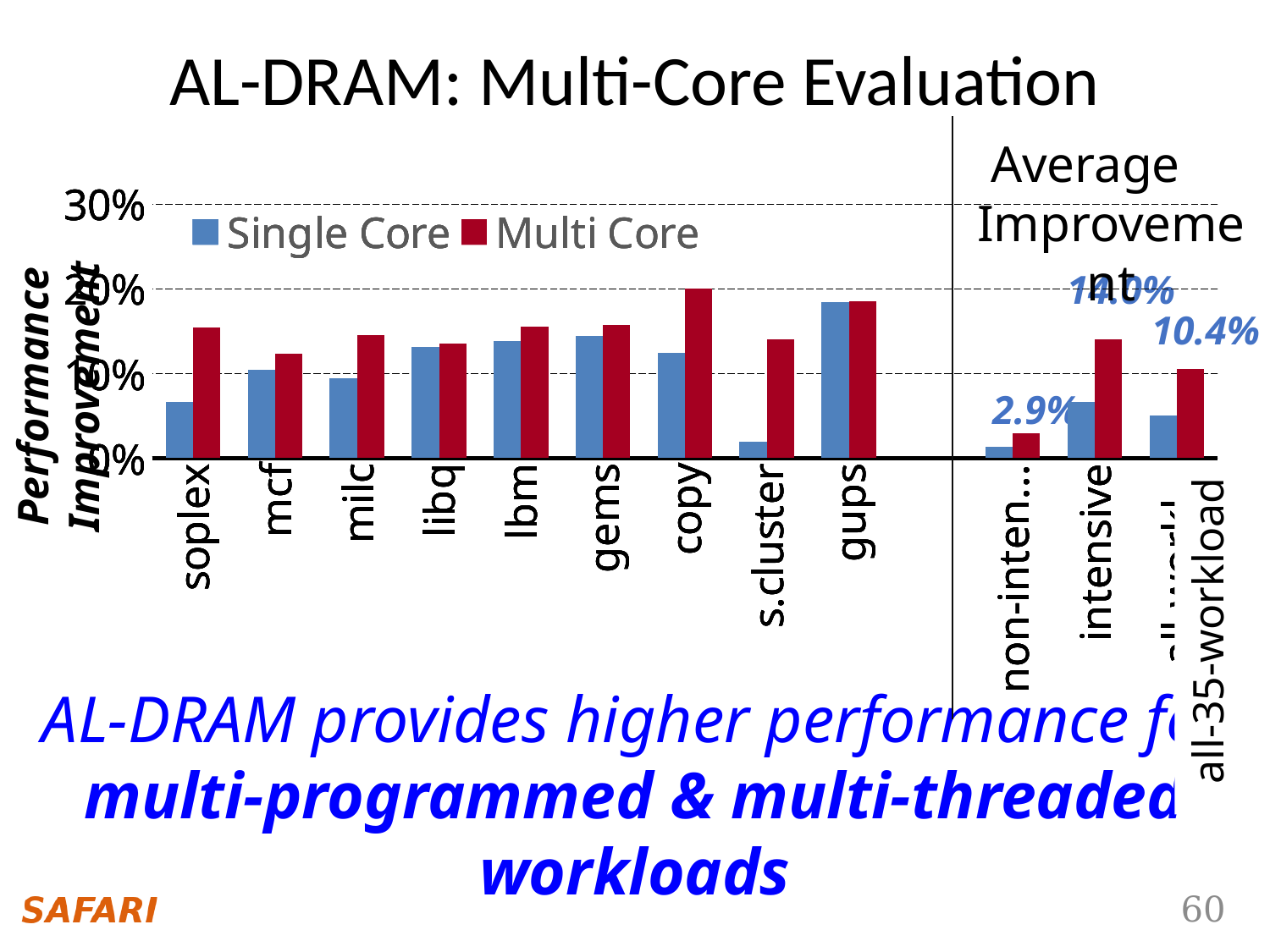
What average improvement value is labeled for the intensive workload group? 14.0% Which workload has the highest Single Core performance improvement? gups Is the Single Core value for s.cluster greater or less than 10%? less How many series does the chart legend list? 2 What type of chart is shown on the slide? bar chart Is the Multi Core value for soplex greater or less than 10%? greater What are the two series named in the chart legend? Single Core and Multi Core Is the Single Core value for gups greater or less than 10%? greater How many individual workloads are plotted to the left of the vertical divider line? 9 Which workload has the highest Multi Core performance improvement? copy For soplex, which is larger: the Single Core or the Multi Core performance improvement? Multi Core What is the title of the slide containing the chart? AL-DRAM: Multi-Core Evaluation